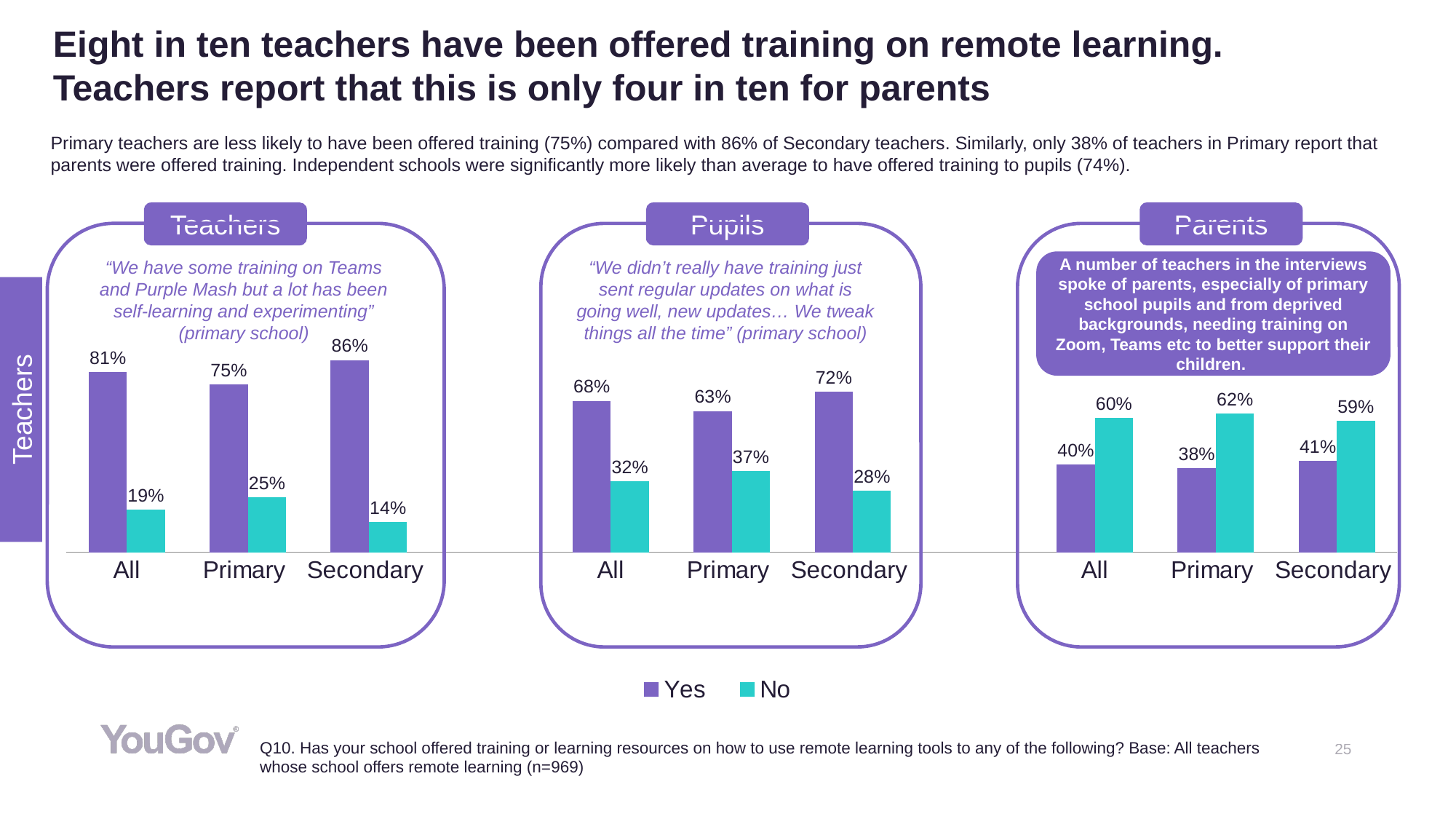
How many categories are shown on the x axis of the Parents chart? 3 In the Parents chart, which is larger for Primary: the 'Yes' value or the 'No' value? No What type of chart is the Teachers chart? Bar chart In the Pupils chart, what is the 'No' value for Primary? 37% In the Teachers chart, what is the difference between the 'Yes' values for Secondary and Primary? 11% In the Pupils chart, which category has the highest 'Yes' value? Secondary In the Parents chart, what is the 'Yes' value for All? 40% In the Pupils chart, what is the difference between the 'Yes' and 'No' values for All? 36% How many series does the legend list? 2 In the Teachers chart, what is the 'Yes' value for Secondary? 86% In the Teachers chart, which category has the lowest 'No' value? Secondary Which colour represents the 'No' series in the legend? Teal